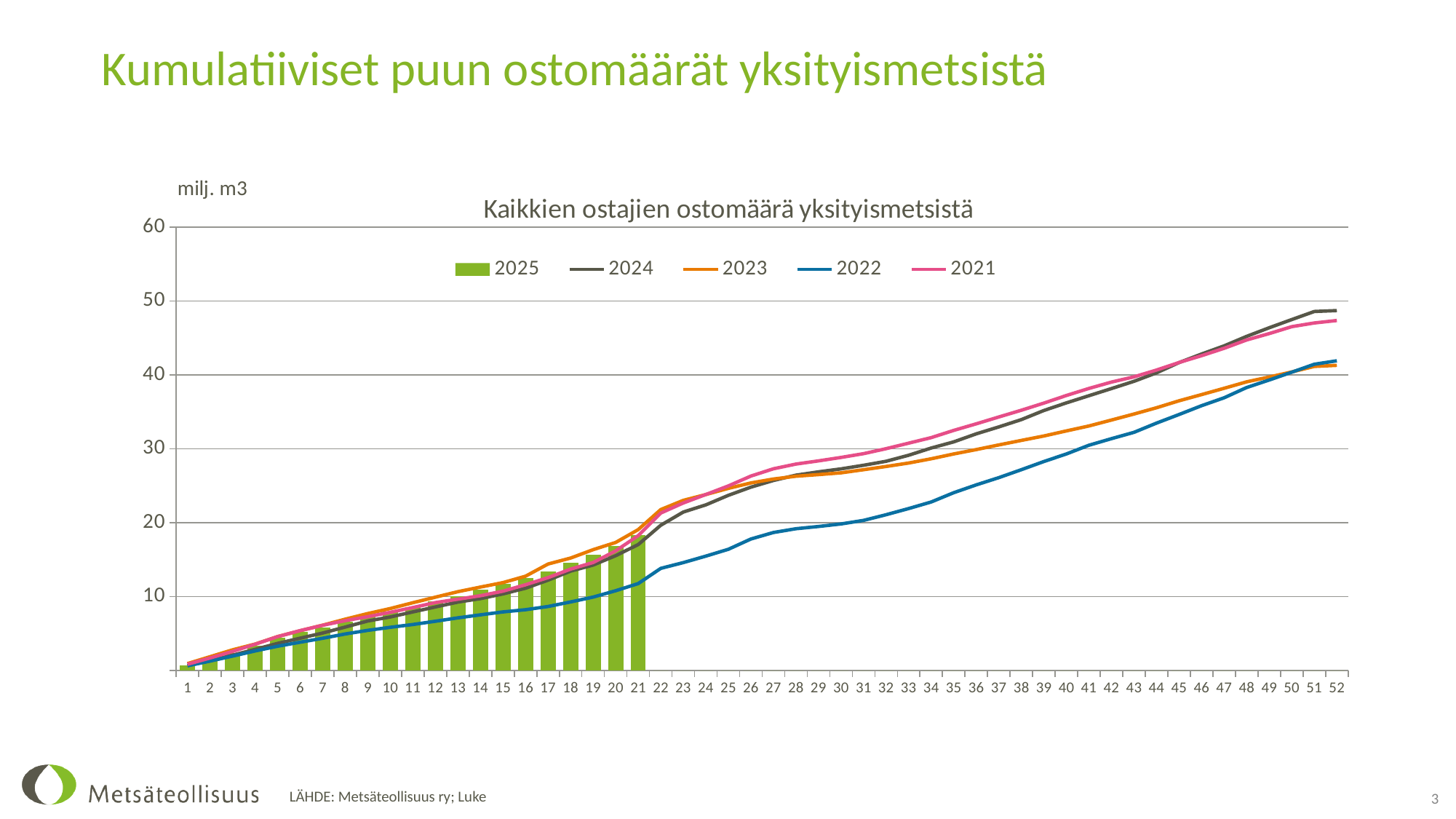
Is the 2022 line at week 26 greater or less than 20? less Is the 2025 bar at week 21 greater or less than 20? less Is the 2024 line at week 52 greater or less than 40? greater At week 21, which is larger: the 2025 bar or the 2022 line? The 2025 bar Which series has the lowest value at week 40? 2022 Up to which week are bars plotted for the 2025 series? 21 Do the cumulative values rise or fall along the x axis? Rise What kind of chart is shown on the slide? A combination chart with bars and lines How many week points are shown on the x axis? 52 What is the title of the chart? Kaikkien ostajien ostomäärä yksityismetsistä How many series does the legend list? 5